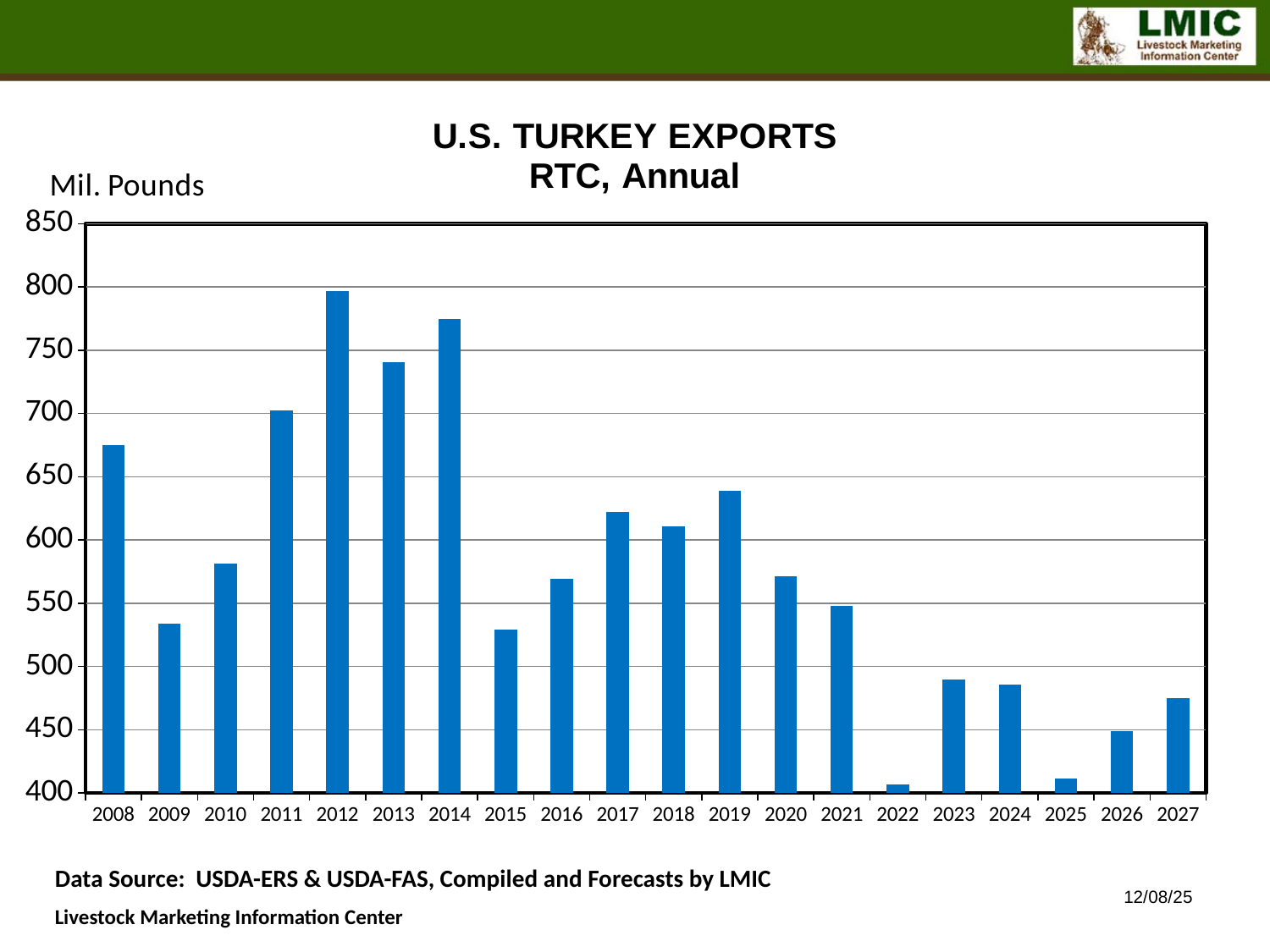
Is the value for 2012 greater or less than 750? greater Is the value for 2023 greater or less than 500? less How many years are plotted on the x axis? 20 Which year has the larger value, 2011 or 2013? 2013 What unit is shown on the y axis label? Mil. Pounds Which year has the highest U.S. turkey exports in the chart? 2012 Which year has the larger value, 2008 or 2019? 2008 Is the value for 2022 greater or less than 450? less What kind of chart is shown on the slide? Bar chart Do the values rise or fall from 2012 to 2015? fall